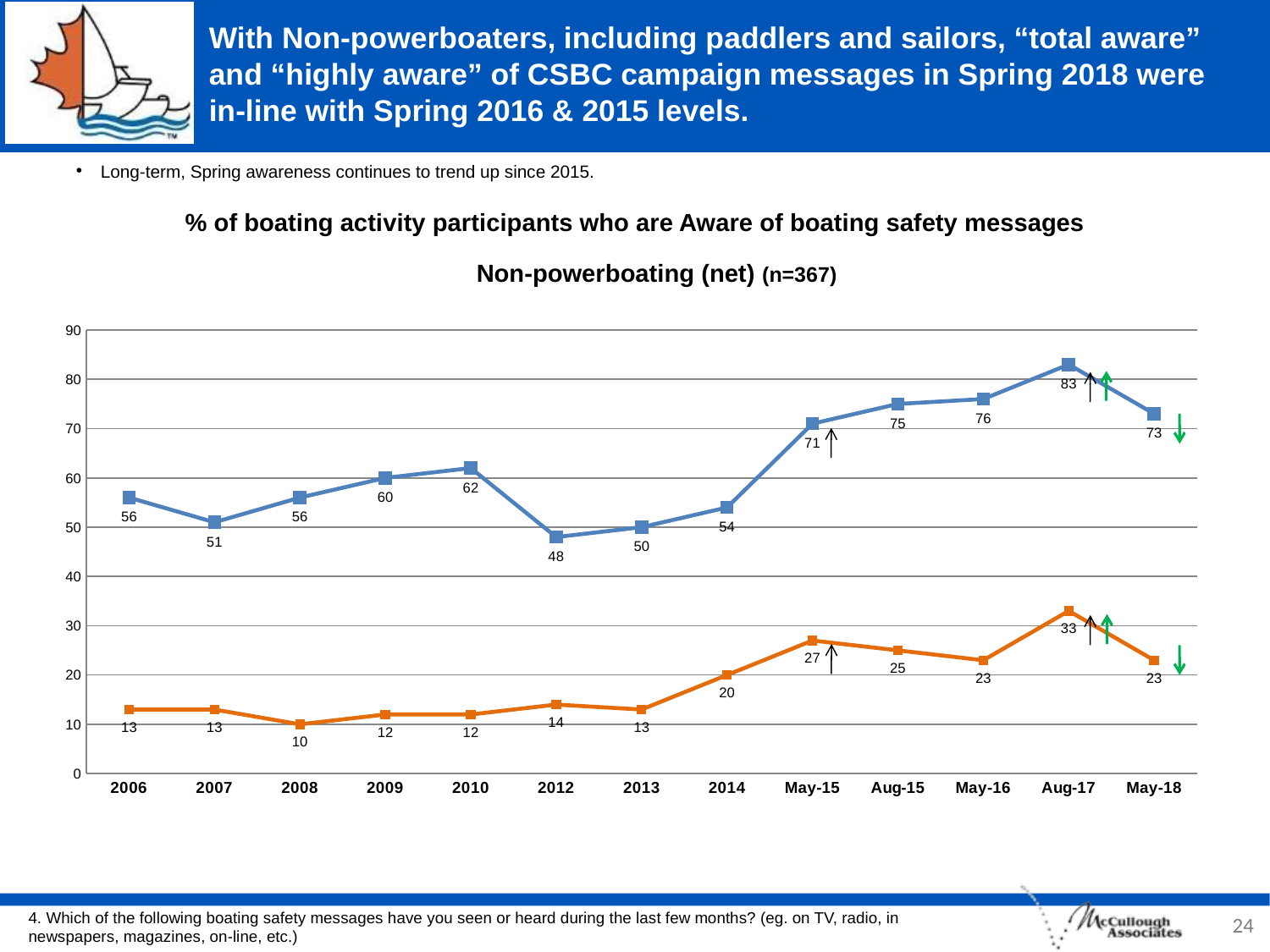
How many time periods are shown on the x axis? 13 What is the difference between the upper (blue) and lower (orange) lines in May-15? 44 In which year does the lower (orange) line have its lowest value? 2008 Which is larger for the upper (blue) line: the value for 2010 or the value for 2014? 2010 What is the value of the upper (blue) line for Aug-17? 83 What type of chart is shown on the slide? Line chart What is the value of the upper (blue) line for 2012? 48 What is the value of the lower (orange) line for May-18? 23 In which period does the upper (blue) line reach its highest value? Aug-17 What is the value of the lower (orange) line for 2014? 20 Does the upper (blue) line rise or fall from 2014 to Aug-17? Rise What is the difference between the upper (blue) line's values for Aug-17 and May-18? 10